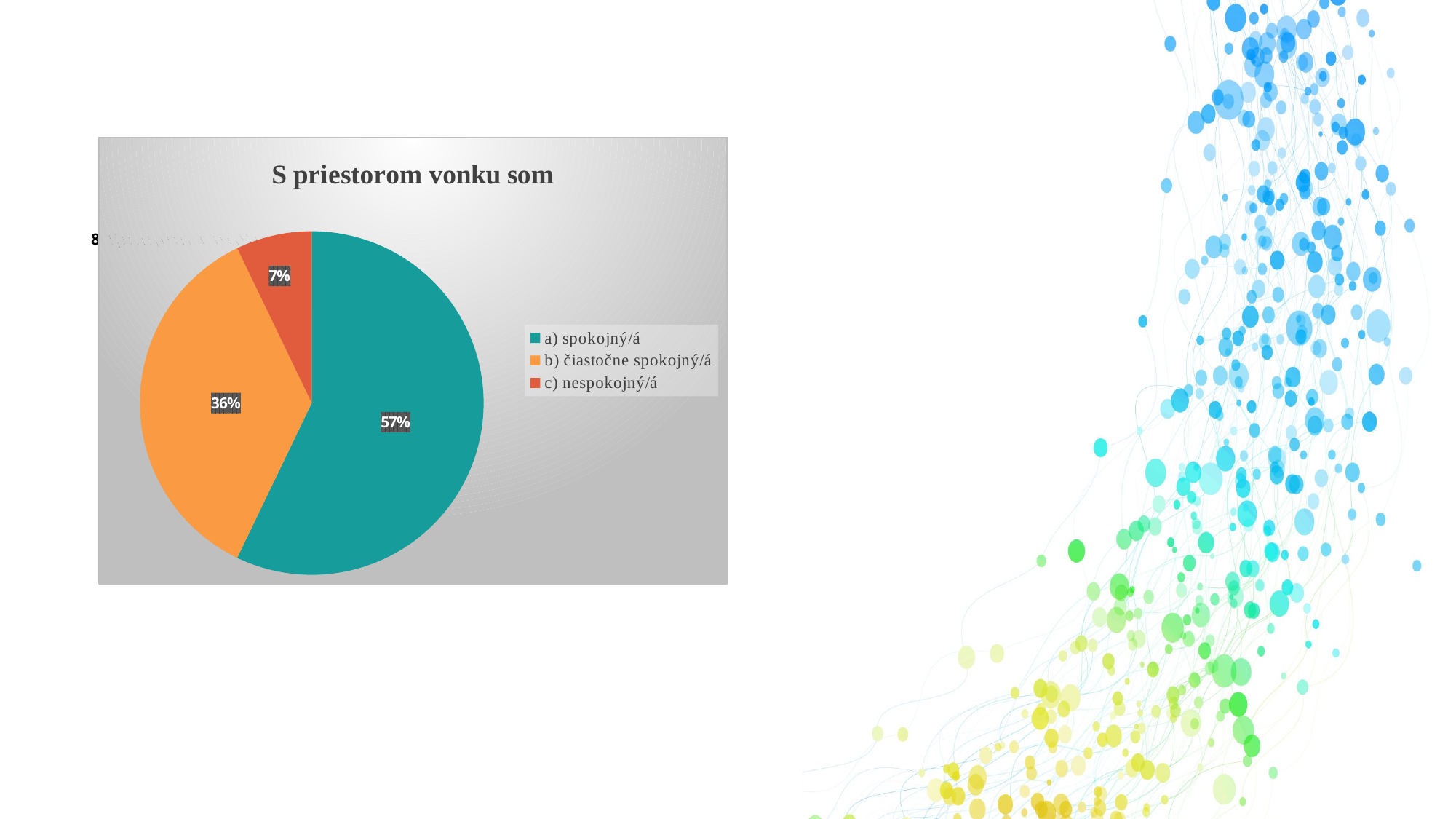
What share of the pie does "a) spokojný/á" have? 57% What colour is the slice for "c) nespokojný/á"? red Which category has the smallest slice of the pie? c) nespokojný/á What is the title of the chart? S priestorom vonku som Which category has the largest slice of the pie? a) spokojný/á Which is larger, the slice for "b) čiastočne spokojný/á" or the slice for "c) nespokojný/á"? b) čiastočne spokojný/á How many categories does the pie chart have? 3 What is the difference in percentage points between "b) čiastočne spokojný/á" and "c) nespokojný/á"? 29 What kind of chart is shown on the slide? pie chart What share of the pie does "c) nespokojný/á" have? 7% What share of the pie does "b) čiastočne spokojný/á" have? 36% What is the difference in percentage points between "a) spokojný/á" and "b) čiastočne spokojný/á"? 21